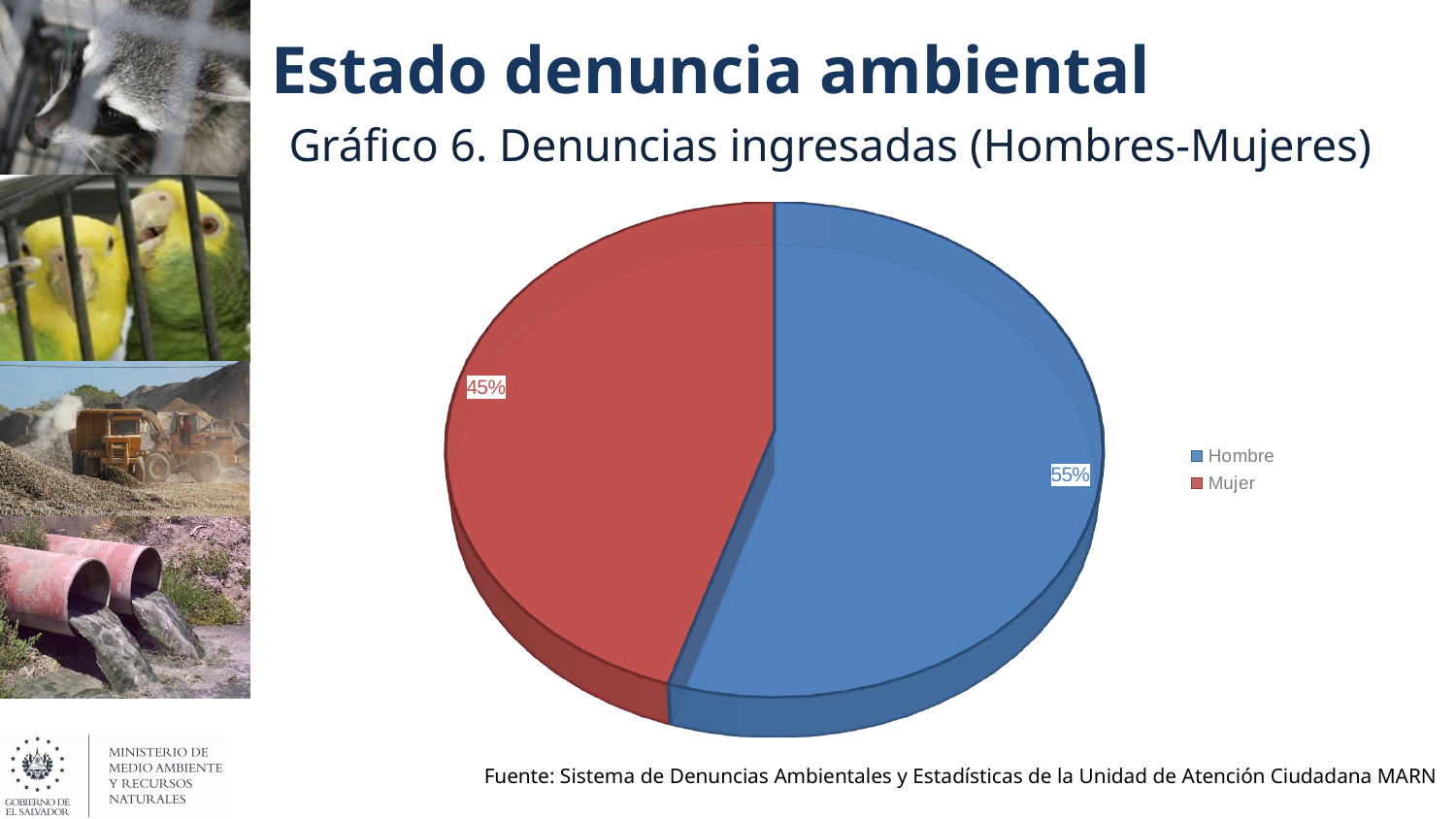
What share of the pie does Hombre represent? 55% What kind of chart is shown on the slide? pie chart What is the title of the chart? Gráfico 6. Denuncias ingresadas (Hombres-Mujeres) What share of the pie does Mujer represent? 45% Which category has the largest share of the pie? Hombre How many entries does the legend list? 2 What is the difference in percentage points between the Hombre and Mujer shares? 10 percentage points Which category has the smallest share of the pie? Mujer How many categories does the pie chart show? 2 What colour is the Mujer slice in the pie chart? red Which is larger, the share for Hombre or the share for Mujer? Hombre